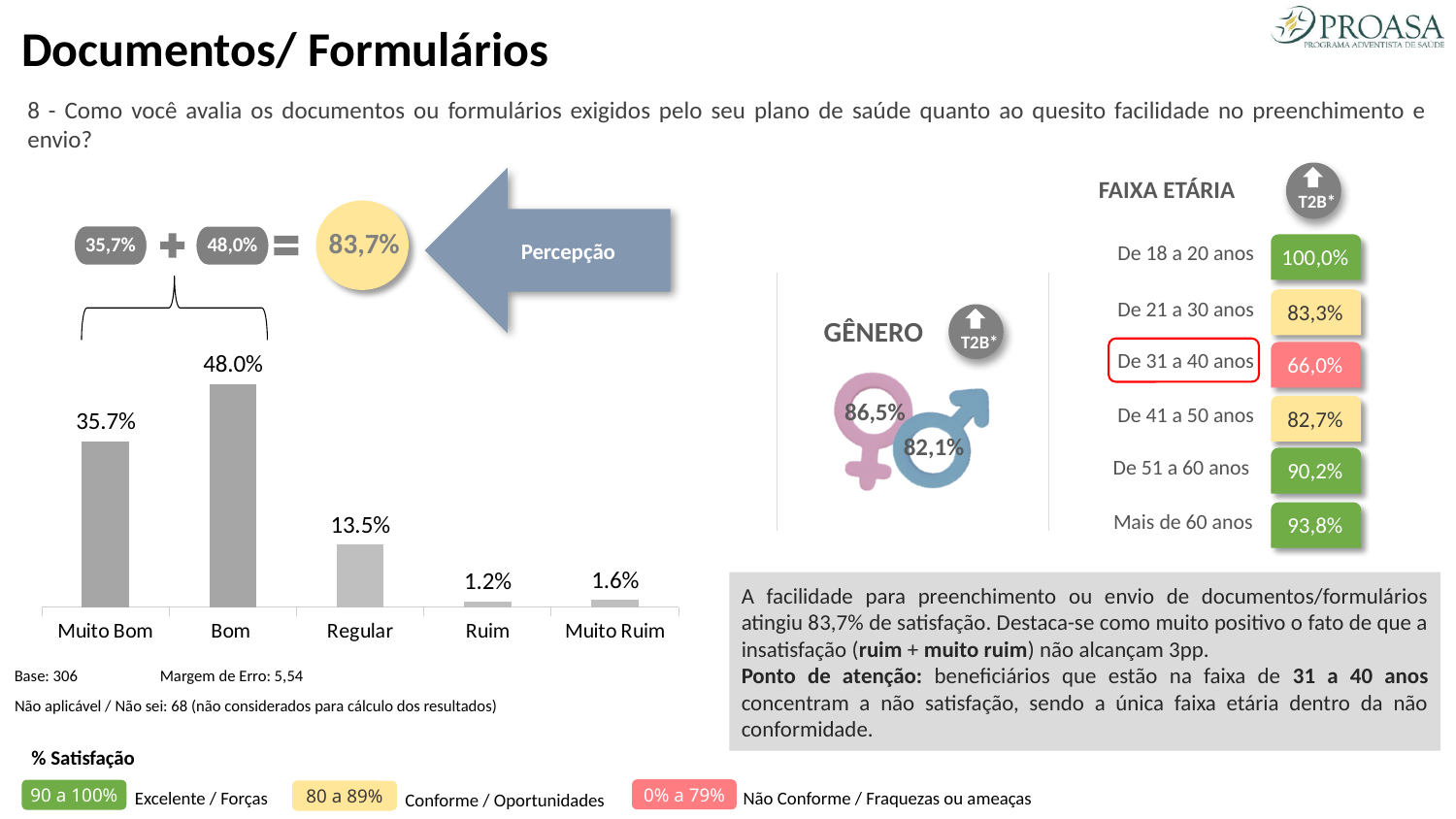
Which category has the lowest value in the bar chart? Ruim What is the value for Ruim in the bar chart? 1.2% What is the value for Regular in the bar chart? 13.5% What is the value for Muito Bom in the bar chart? 35.7% How many categories are shown in the bar chart? 5 What is the value for Bom in the bar chart? 48.0% What is the combined value of Muito Bom and Bom shown in the circle above the bar chart? 83,7% What is the base (number of respondents) stated below the bar chart? 306 What kind of chart is used to show the evaluation categories (Muito Bom to Muito Ruim)? Bar chart Which is larger in the bar chart, Regular or Muito Ruim? Regular Which category has the highest value in the bar chart? Bom What is the difference between the values for Bom and Muito Bom in the bar chart? 12.3%